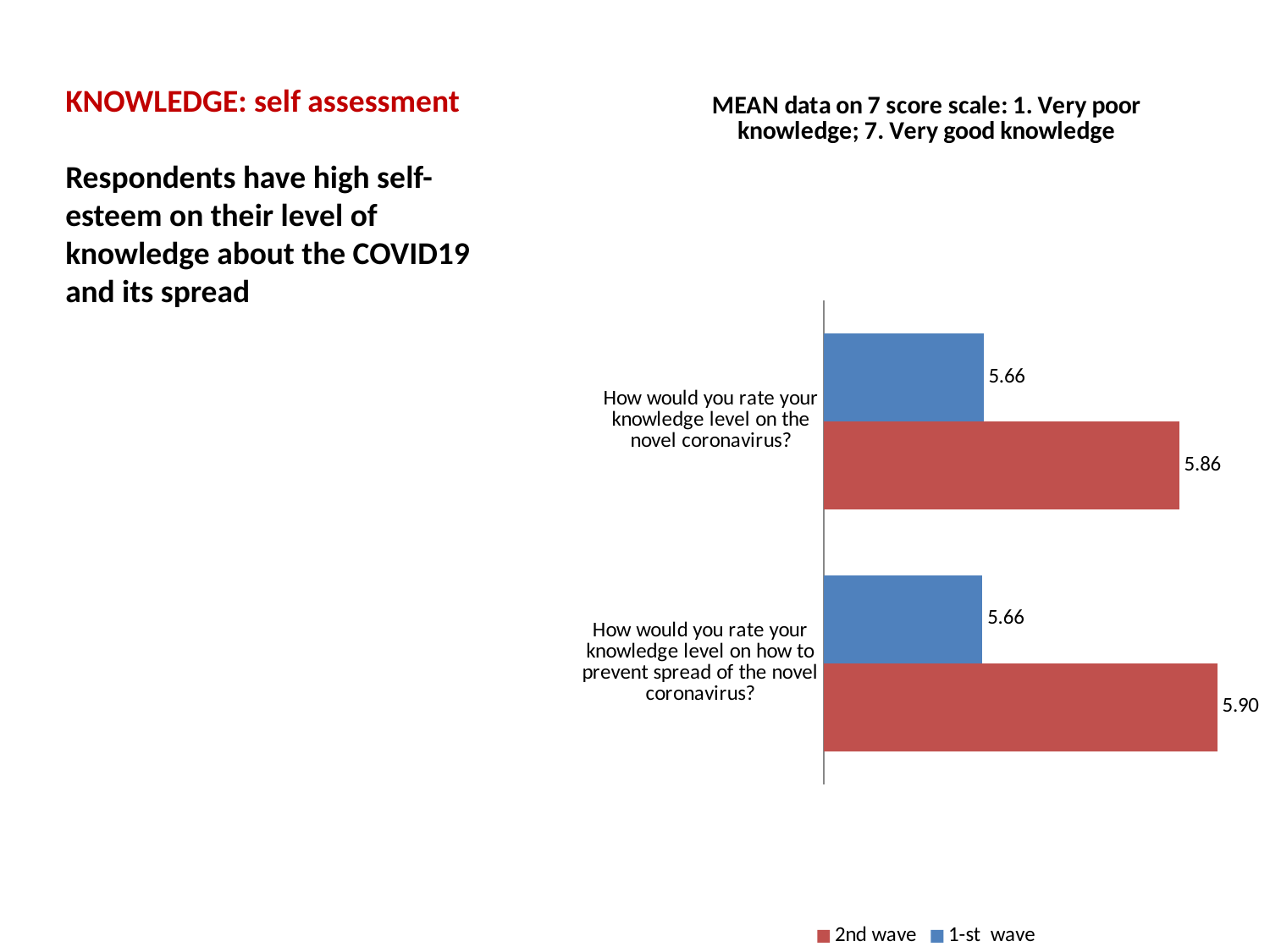
How many question categories are plotted in the chart? 2 What is the difference between the 2nd wave and 1-st wave values for "How would you rate your knowledge level on how to prevent spread of the novel coronavirus?" 0.24 What is the 1-st wave value for "How would you rate your knowledge level on the novel coronavirus?" 5.66 How many series does the chart legend list? 2 For the question about preventing spread of the novel coronavirus, which series has the larger value, 2nd wave or 1-st wave? 2nd wave What is the difference between the 2nd wave and 1-st wave values for "How would you rate your knowledge level on the novel coronavirus?" 0.20 Which bar has the highest value in the chart? 2nd wave, knowledge level on how to prevent spread of the novel coronavirus (5.90) What is the 1-st wave value for "How would you rate your knowledge level on how to prevent spread of the novel coronavirus?" 5.66 What colour are the 2nd wave bars in the chart? red What kind of chart is shown on the slide? bar chart What is the 2nd wave value for "How would you rate your knowledge level on the novel coronavirus?" 5.86 What is the 2nd wave value for "How would you rate your knowledge level on how to prevent spread of the novel coronavirus?" 5.90